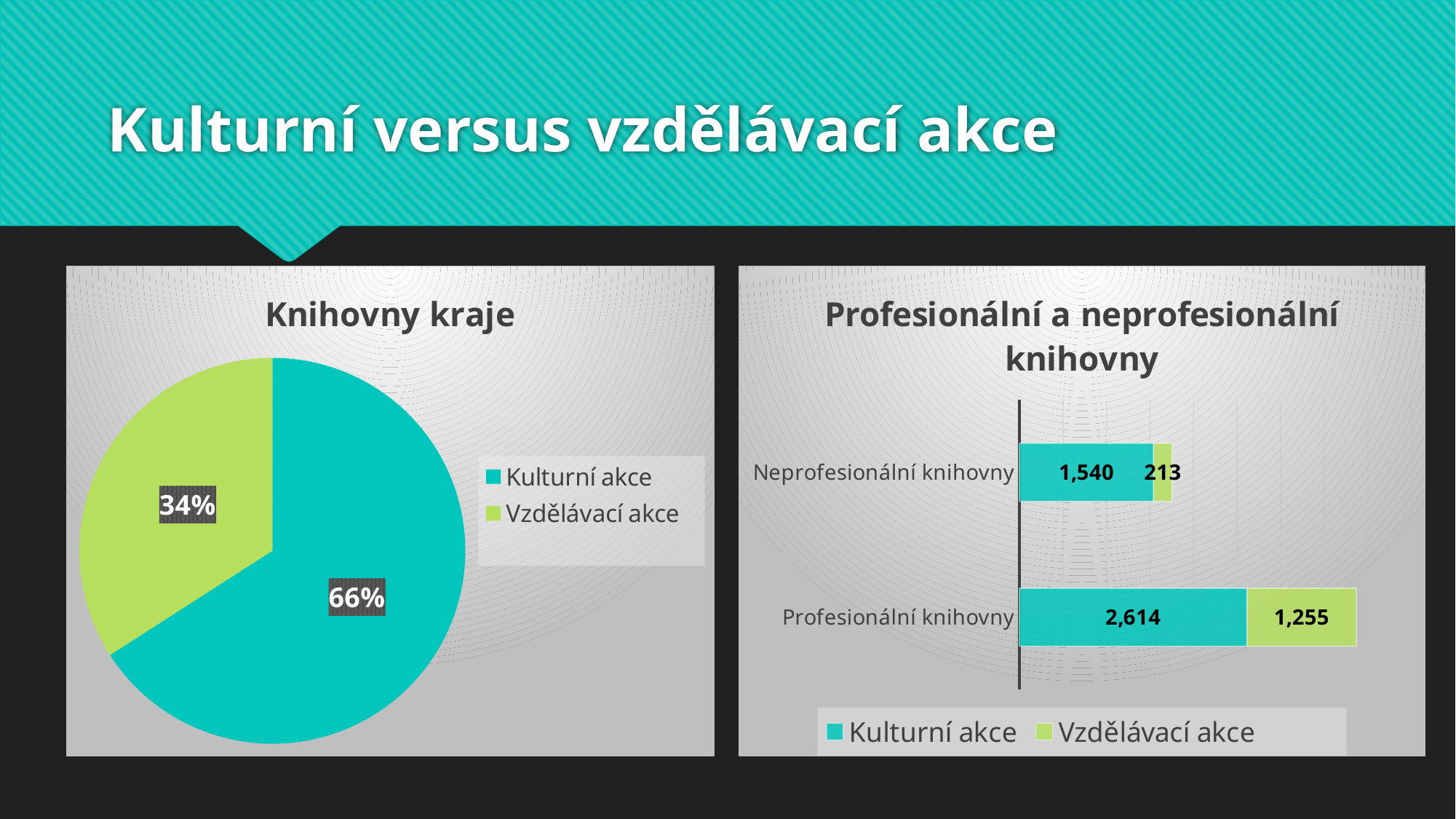
What kind of chart is the 'Knihovny kraje' chart? Pie chart In the 'Profesionální a neprofesionální knihovny' chart, what is the value of Kulturní akce for Profesionální knihovny? 2,614 In the 'Profesionální a neprofesionální knihovny' chart, what is the total of the stacked bar for Profesionální knihovny? 3,869 In the 'Knihovny kraje' chart, what share of the pie is Vzdělávací akce? 34% In the 'Knihovny kraje' chart, what share of the pie is Kulturní akce? 66% What kind of chart is the 'Profesionální a neprofesionální knihovny' chart? Bar chart How many categories does the 'Profesionální a neprofesionální knihovny' chart show? 2 In the 'Knihovny kraje' chart, which slice is larger, Kulturní akce or Vzdělávací akce? Kulturní akce In the 'Profesionální a neprofesionální knihovny' chart, what is the total of the stacked bar for Neprofesionální knihovny? 1,753 How many series does the legend of the 'Knihovny kraje' chart list? 2 In the 'Profesionální a neprofesionální knihovny' chart, what is the difference between Kulturní akce for Profesionální knihovny and Kulturní akce for Neprofesionální knihovny? 1,074 In the 'Profesionální a neprofesionální knihovny' chart, what is the value of Vzdělávací akce for Neprofesionální knihovny? 213